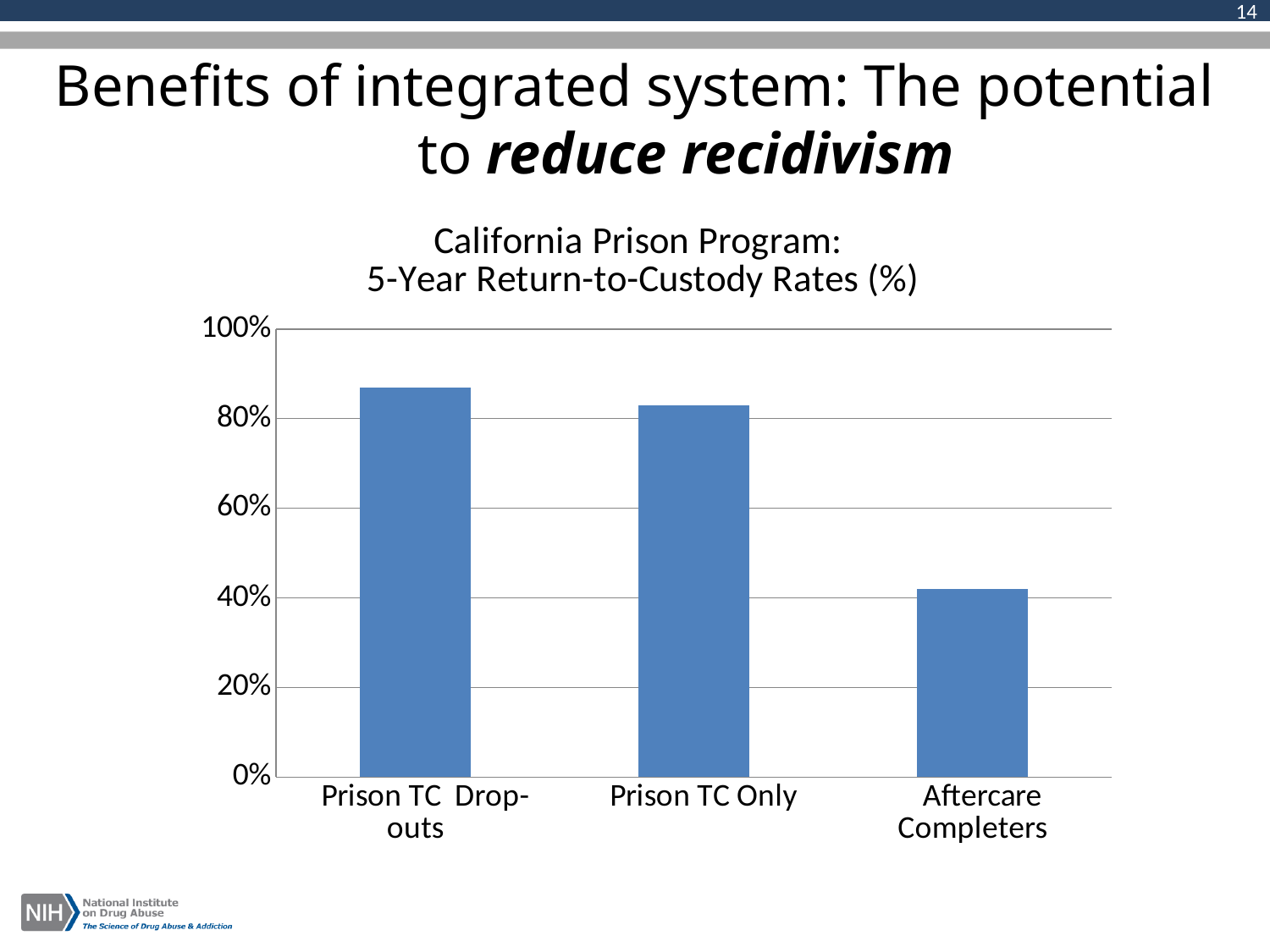
Which category has the lowest 5-year return-to-custody rate? Aftercare Completers Is the value for Aftercare Completers greater or less than 60%? less Is the value for Prison TC Drop-outs greater or less than 80%? greater What is the highest value shown on the y axis of the chart? 100% Which category has the highest 5-year return-to-custody rate? Prison TC Drop-outs What type of chart is shown on the slide? bar chart What is the title of the chart? California Prison Program: 5-Year Return-to-Custody Rates (%) How many categories are shown on the x axis of the chart? 3 Do the values rise or fall moving from left to right along the x axis? fall Is the value for Prison TC Only greater or less than 80%? greater Which is larger, the value for Prison TC Only or the value for Aftercare Completers? Prison TC Only